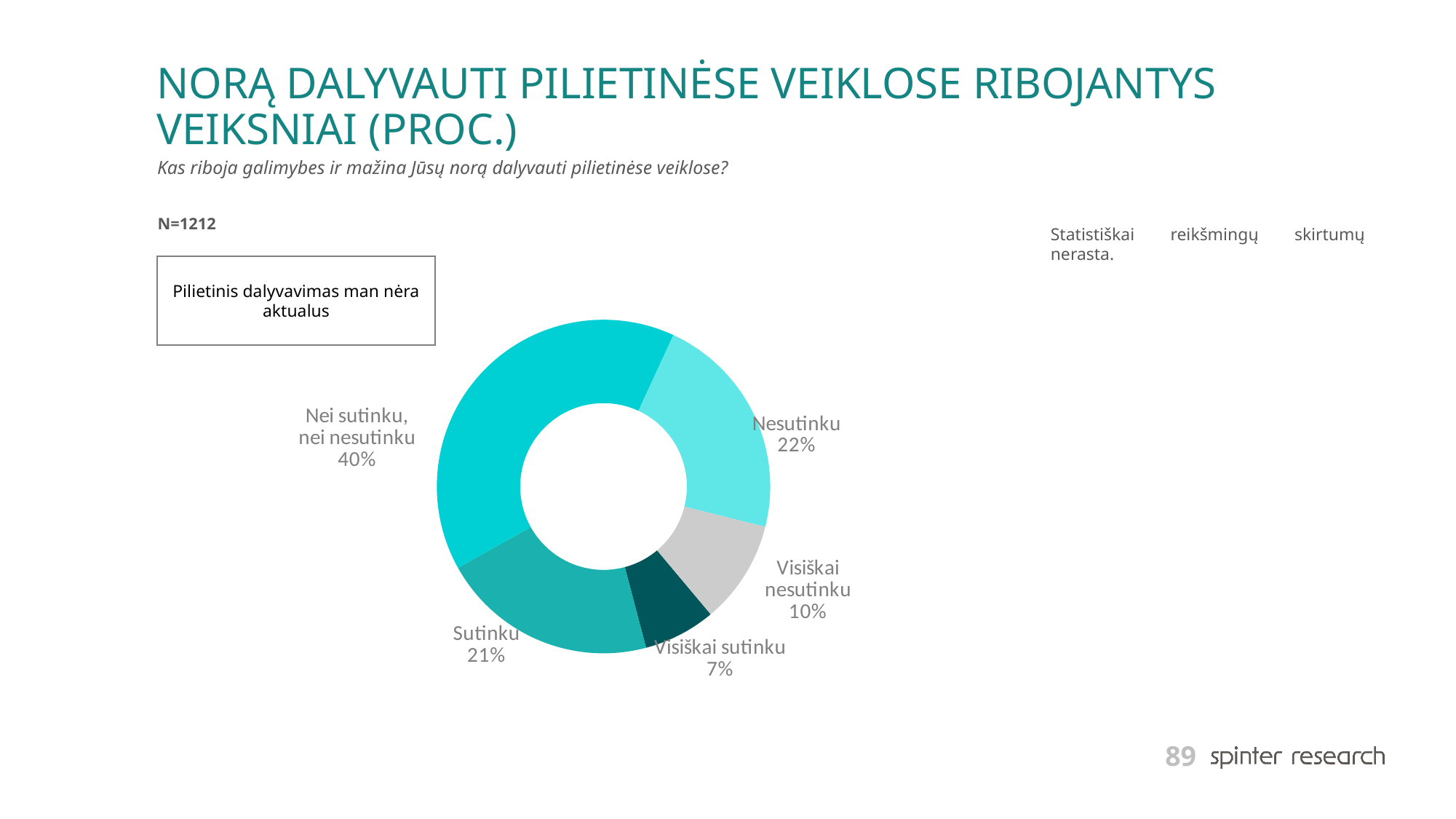
What share of respondents answered "Visiškai nesutinku"? 10% What share of respondents answered "Sutinku"? 21% Which is larger: the share for "Visiškai nesutinku" or for "Visiškai sutinku"? Visiškai nesutinku What share of respondents answered "Nei sutinku, nei nesutinku"? 40% What share of respondents answered "Nesutinku"? 22% What is the sample size (N) stated on the slide? N=1212 Which response category has the smallest share? Visiškai sutinku Which response category has the largest share? Nei sutinku, nei nesutinku How many response categories are shown in the chart? 5 What kind of chart is shown on the slide? Doughnut (pie) chart What share of respondents answered "Visiškai sutinku"? 7% What is the difference in percentage points between "Nei sutinku, nei nesutinku" and "Nesutinku"? 18